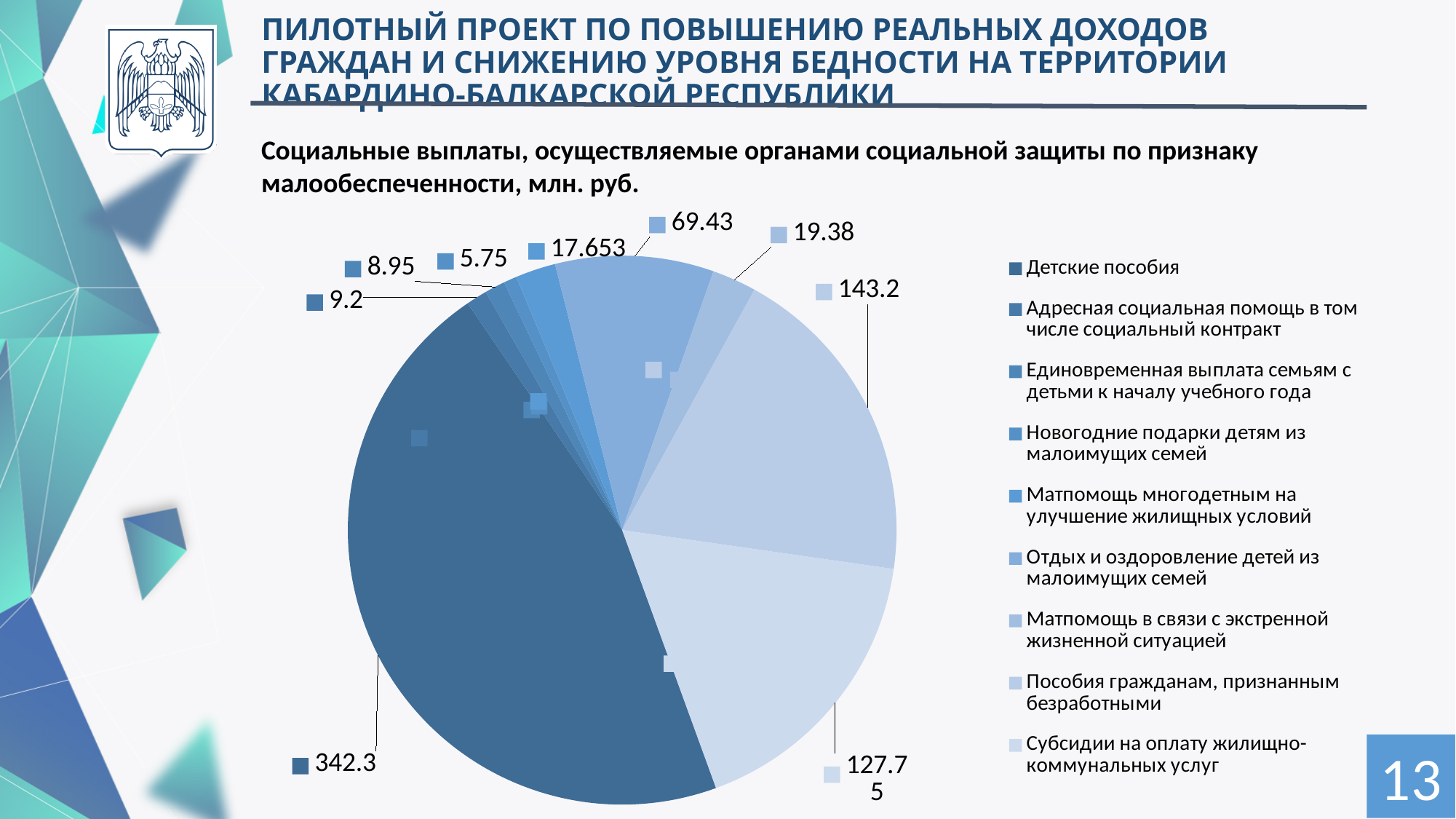
What is the value for Отдых и оздоровление детей из малоимущих семей? 69.43 What is the value for Субсидии на оплату жилищно-коммунальных услуг? 127.75 What unit of measurement is stated in the chart title? млн. руб. What type of chart is shown on the slide? pie chart Which is larger: Отдых и оздоровление детей из малоимущих семей or Матпомощь в связи с экстренной жизненной ситуацией? Отдых и оздоровление детей из малоимущих семей Which category has the largest slice of the pie? Детские пособия What is the difference between the values for Пособия гражданам, признанным безработными and Субсидии на оплату жилищно-коммунальных услуг? 15.45 Which category has the smallest slice of the pie? Новогодние подарки детям из малоимущих семей What is the value for Матпомощь многодетным на улучшение жилищных условий? 17.653 What is the value for Детские пособия? 342.3 How many categories does the legend of the pie chart list? 9 What is the value for Пособия гражданам, признанным безработными? 143.2